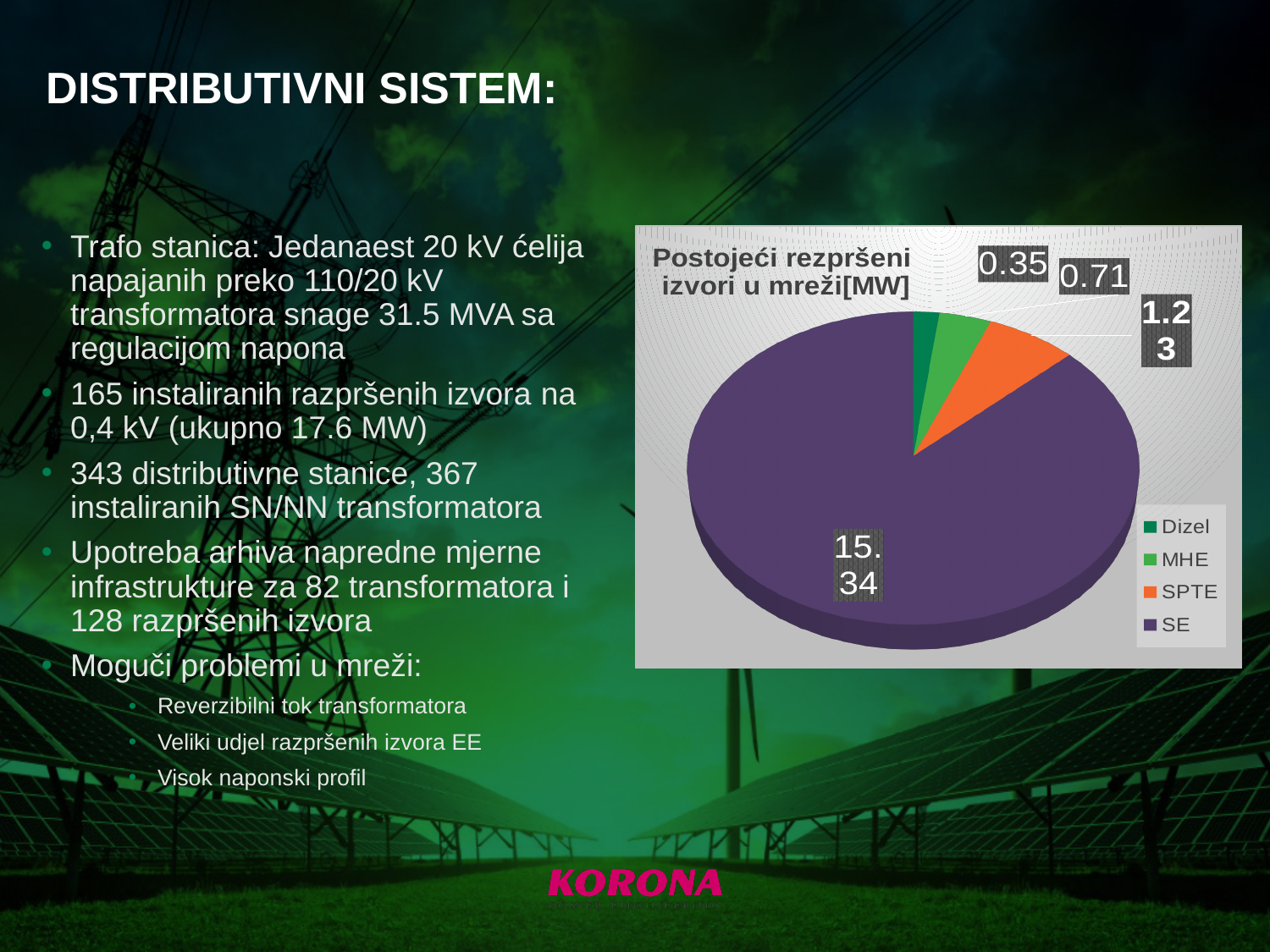
Which category has the smallest slice of the pie? Dizel What is the value for SE in the pie chart? 15.34 Which is larger, the value for SPTE or the value for MHE? SPTE What type of chart is shown on the slide? pie chart What is the value for SPTE in the pie chart? 1.23 How many categories does the chart's legend list? 4 Which category has the largest slice of the pie? SE What is the value for MHE in the pie chart? 0.71 What colour is the SE slice in the pie chart? purple What is the title of the chart? Postojeći rezpršeni izvori u mreži[MW] What is the value for Dizel in the pie chart? 0.35 What is the difference between the values for SE and SPTE? 14.11